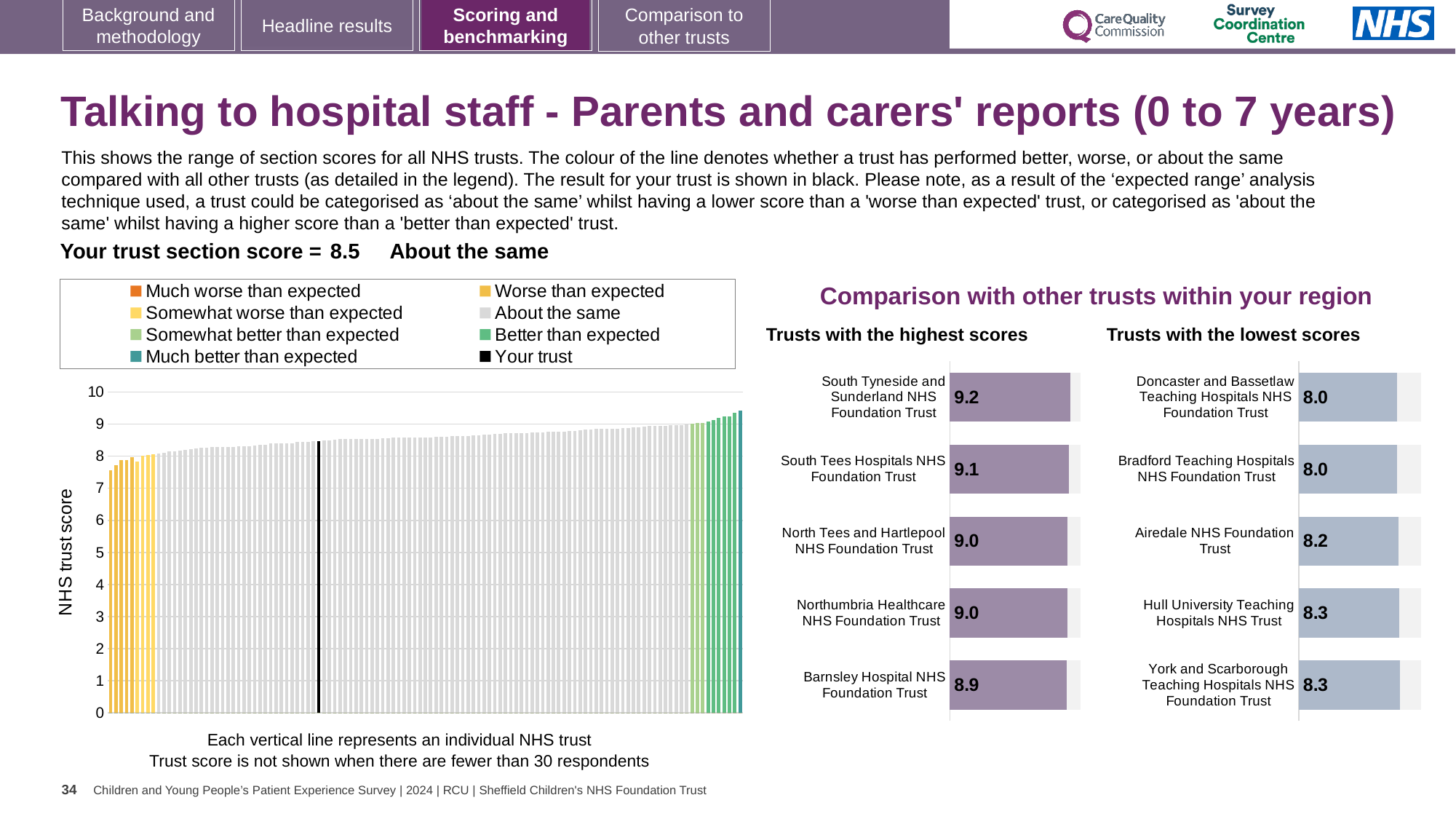
What kind of chart is the 'Trusts with the highest scores' chart? Bar chart In the 'Trusts with the highest scores' chart, which trust has the lowest score? Barnsley Hospital NHS Foundation Trust In the main 'NHS trust score' chart, do the trust scores rise or fall from left to right? Rise How many trusts are shown in the 'Trusts with the lowest scores' chart? 5 How many entries does the legend of the main 'NHS trust score' chart list? 8 In the 'Trusts with the highest scores' chart, what is the difference between the scores of South Tyneside and Sunderland NHS Foundation Trust and Barnsley Hospital NHS Foundation Trust? 0.3 In the 'Trusts with the highest scores' chart, which trust has the highest score? South Tyneside and Sunderland NHS Foundation Trust What is your trust's section score shown on the slide? 8.5 What is the y-axis title of the main chart on the left of the slide? NHS trust score In the 'Trusts with the highest scores' chart, what is the score for South Tyneside and Sunderland NHS Foundation Trust? 9.2 In the 'Trusts with the lowest scores' chart, which has the higher score: Hull University Teaching Hospitals NHS Trust or Airedale NHS Foundation Trust? Hull University Teaching Hospitals NHS Trust In the 'Trusts with the lowest scores' chart, what is the score for Airedale NHS Foundation Trust? 8.2